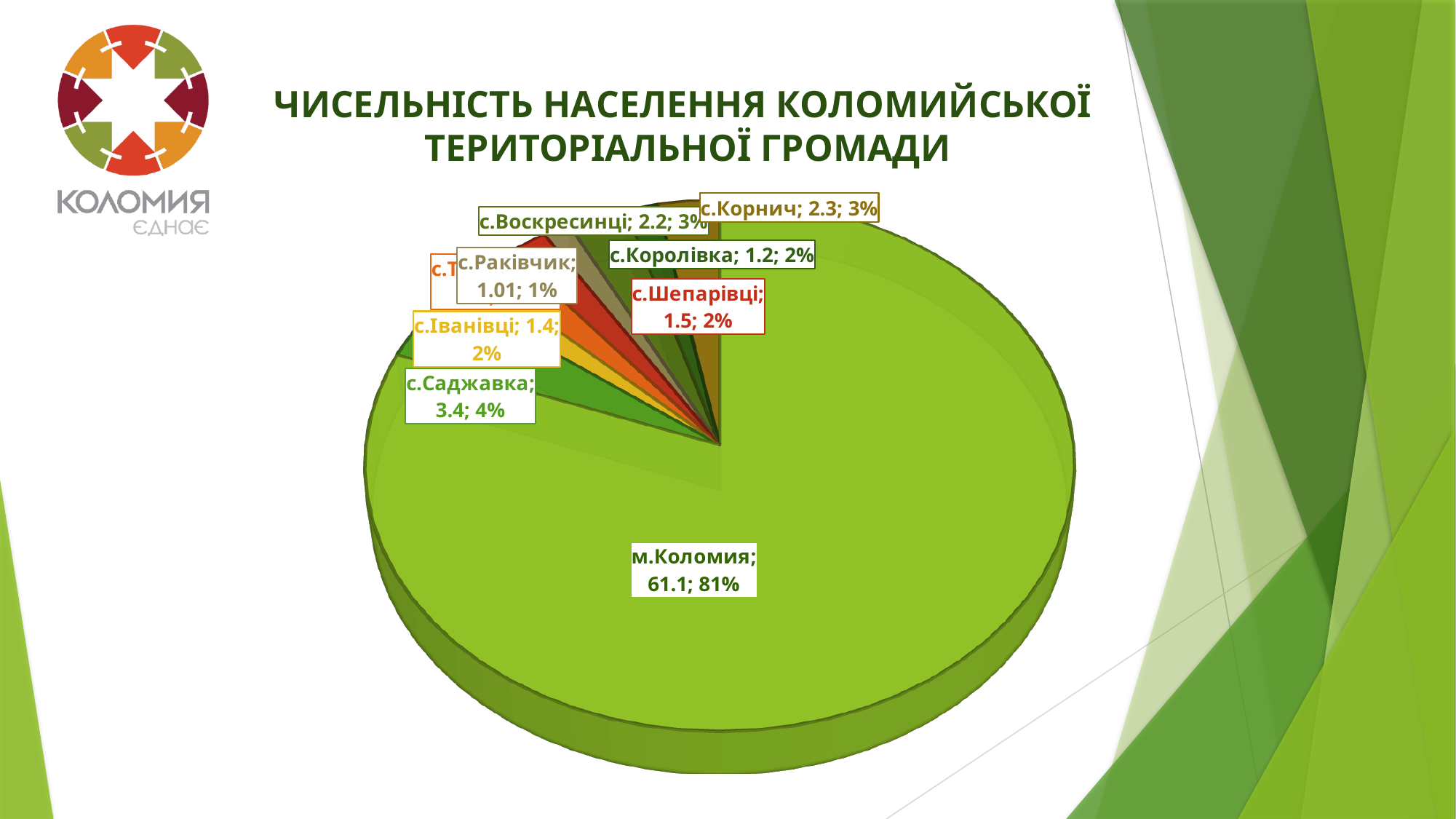
What share of the pie does с.Саджавка represent? 4% What is the value shown for с.Корнич? 2.3 What is the value shown for с.Раківчик? 1.01 What is the value shown for м.Коломия? 61.1 What kind of chart is shown on the slide? pie chart What share of the pie does с.Воскресинці represent? 3% Which is larger, the value for с.Корнич or the value for с.Воскресинці? с.Корнич Which category has the largest slice of the pie? м.Коломия What share of the pie does м.Коломия represent? 81% What is the value shown for с.Саджавка? 3.4 What is the title of the chart? ЧИСЕЛЬНІСТЬ НАСЕЛЕННЯ КОЛОМИЙСЬКОЇ ТЕРИТОРІАЛЬНОЇ ГРОМАДИ What is the difference between the values for м.Коломия and с.Саджавка? 57.7